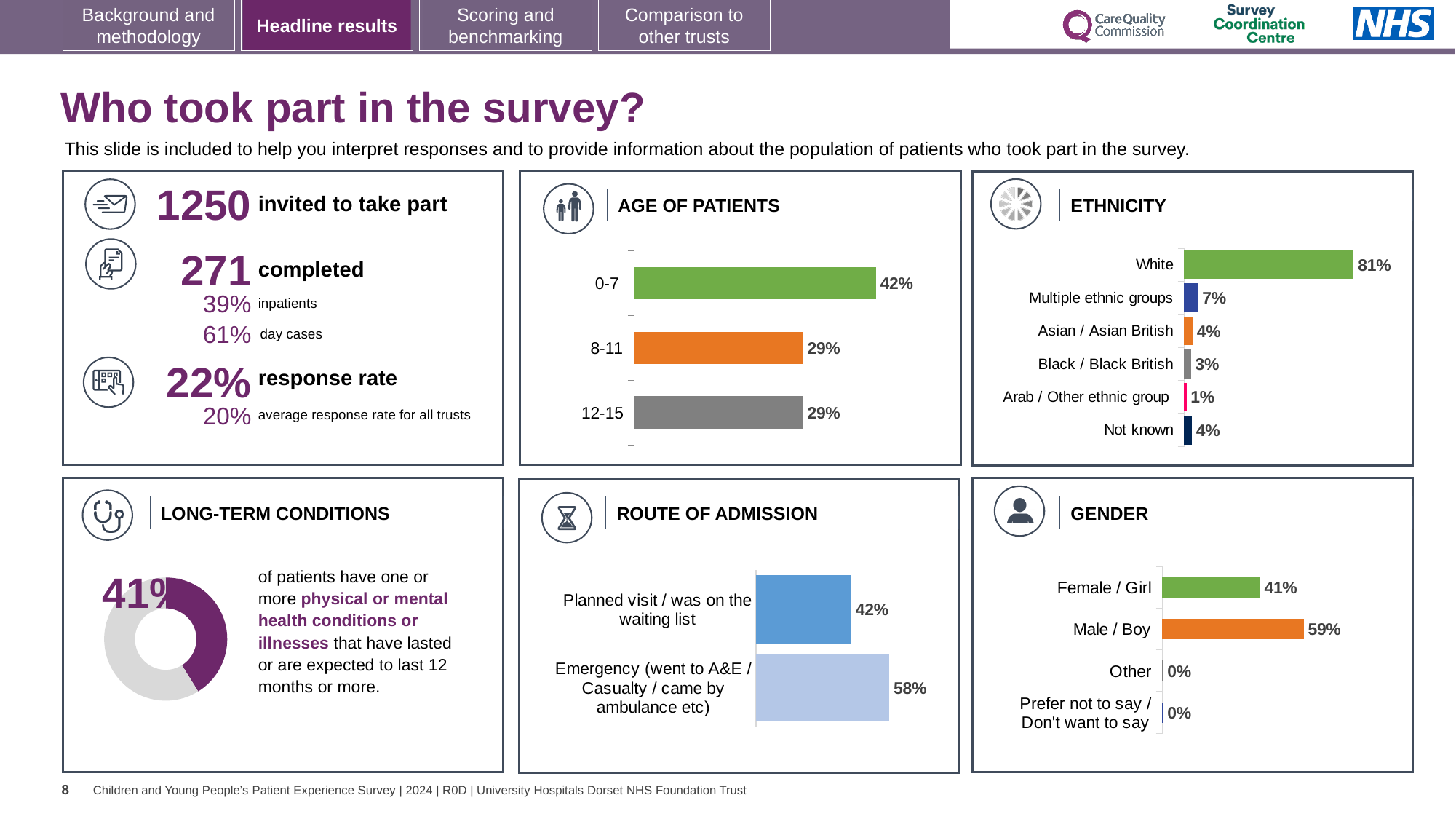
In the ETHNICITY chart, which category has the highest value? White In the AGE OF PATIENTS chart, what is the value for the 0-7 age group? 42% In the ROUTE OF ADMISSION chart, which is larger: Planned visit / was on the waiting list or Emergency? Emergency In the ETHNICITY chart, how many categories are shown? 6 In the ROUTE OF ADMISSION chart, what is the value for Emergency (went to A&E / Casualty / came by ambulance etc)? 58% What kind of chart is the LONG-TERM CONDITIONS chart? Doughnut chart In the GENDER chart, what is the difference between Male / Boy and Female / Girl? 18% In the ETHNICITY chart, which category has the lowest value? Arab / Other ethnic group In the ETHNICITY chart, what is the value for Multiple ethnic groups? 7% In the AGE OF PATIENTS chart, how many age categories are shown? 3 In the ETHNICITY chart, what is the difference between White and Multiple ethnic groups? 74% In the GENDER chart, what is the value for Male / Boy? 59%